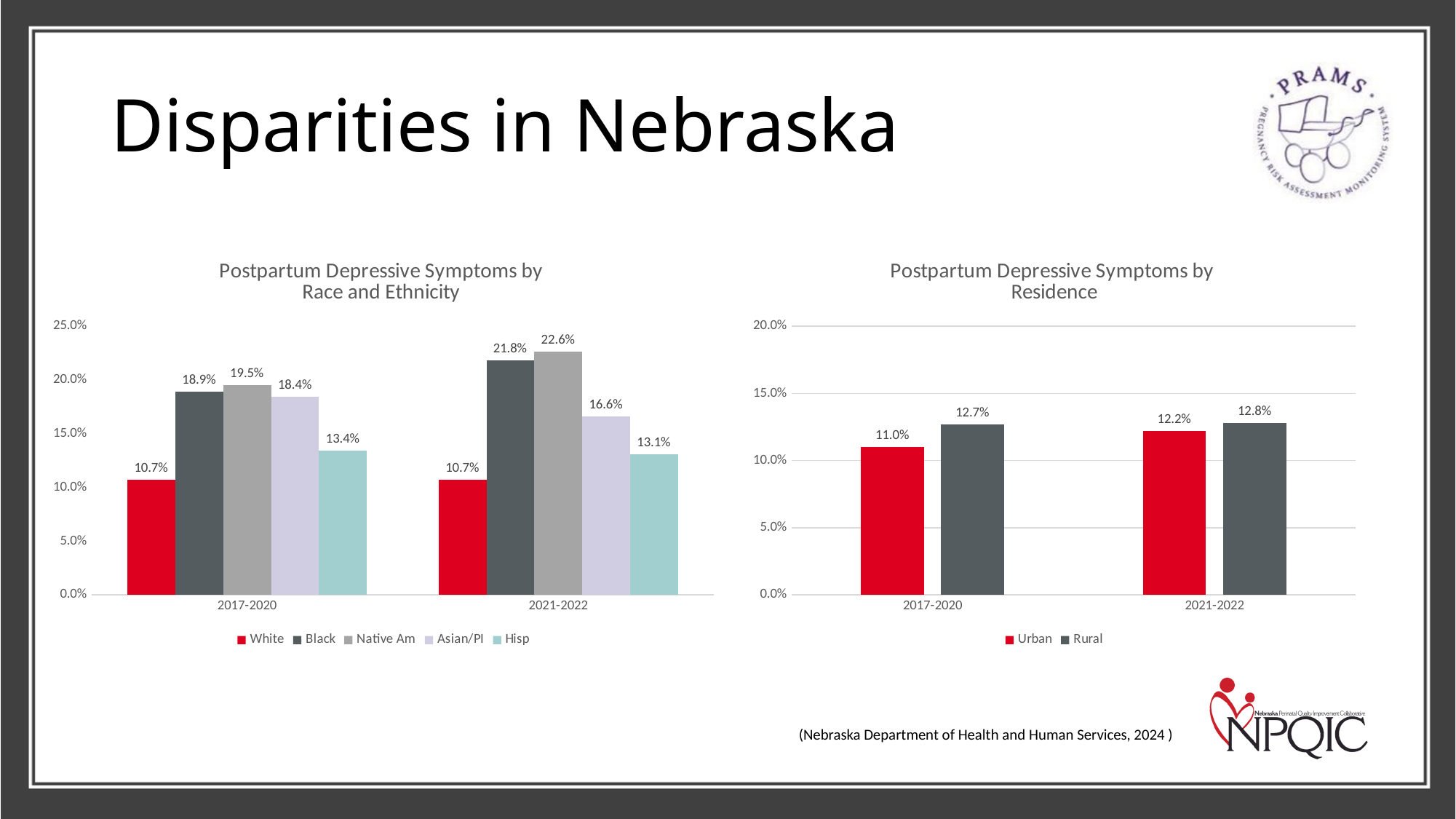
In the 'Postpartum Depressive Symptoms by Residence' chart, what is the Rural value for 2021-2022? 12.8% What kind of chart is the 'Postpartum Depressive Symptoms by Residence' chart? Bar chart In the 'Postpartum Depressive Symptoms by Race and Ethnicity' chart, how many series does the legend list? 5 In the 'Postpartum Depressive Symptoms by Race and Ethnicity' chart, what is the difference between the Black value in 2021-2022 and the Black value in 2017-2020? 2.9% In the 'Postpartum Depressive Symptoms by Residence' chart, which is larger in 2017-2020, Urban or Rural? Rural In the 'Postpartum Depressive Symptoms by Residence' chart, what is the difference between the Rural and Urban values in 2017-2020? 1.7% In the 'Postpartum Depressive Symptoms by Residence' chart, what is the Urban value for 2017-2020? 11.0% In the 'Postpartum Depressive Symptoms by Race and Ethnicity' chart, what is the value for Native Am in 2021-2022? 22.6% In the 'Postpartum Depressive Symptoms by Race and Ethnicity' chart, is the Hisp value for 2021-2022 greater or less than 15.0%? less In the 'Postpartum Depressive Symptoms by Race and Ethnicity' chart, what is the value for Asian/PI in 2017-2020? 18.4% In the 'Postpartum Depressive Symptoms by Race and Ethnicity' chart, which group has the highest value in 2021-2022? Native Am In the 'Postpartum Depressive Symptoms by Race and Ethnicity' chart, which group has the lowest value in 2017-2020? White